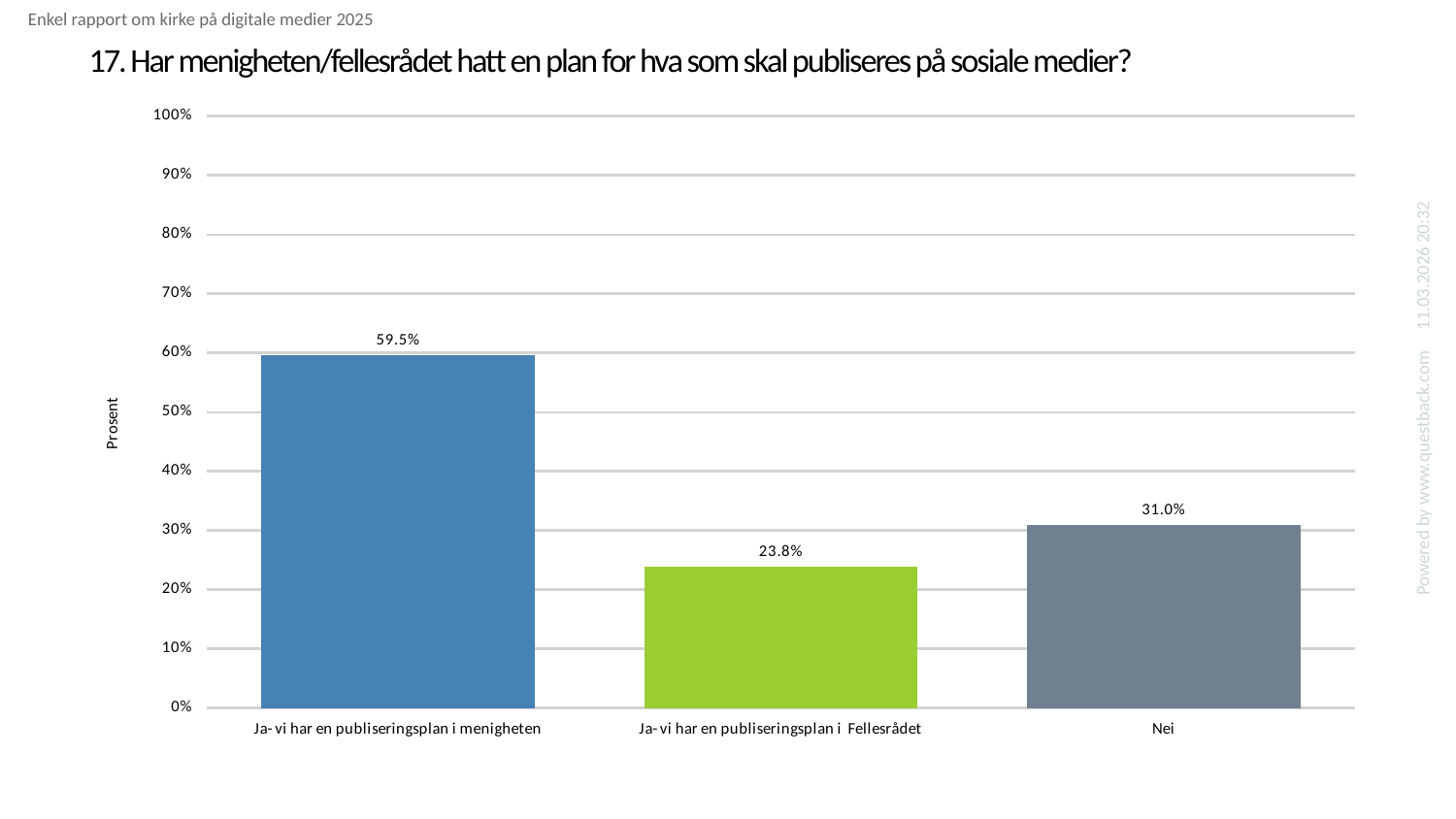
What is the value for "Ja- vi har en publiseringsplan i menigheten"? 59.5% What kind of chart is shown on the slide? Bar chart What is the value for "Ja- vi har en publiseringsplan i Fellesrådet"? 23.8% What is the difference between the values for "Ja- vi har en publiseringsplan i menigheten" and "Nei"? 28.5% Which is larger, the value for "Nei" or the value for "Ja- vi har en publiseringsplan i Fellesrådet"? Nei What is the value for "Nei"? 31.0% How many categories are shown on the x axis? 3 Is the value for "Ja- vi har en publiseringsplan i menigheten" greater or less than 50%? greater What is the label of the y axis? Prosent What is the difference between the values for "Nei" and "Ja- vi har en publiseringsplan i Fellesrådet"? 7.2% Which category has the highest value? Ja- vi har en publiseringsplan i menigheten Which category has the lowest value? Ja- vi har en publiseringsplan i Fellesrådet